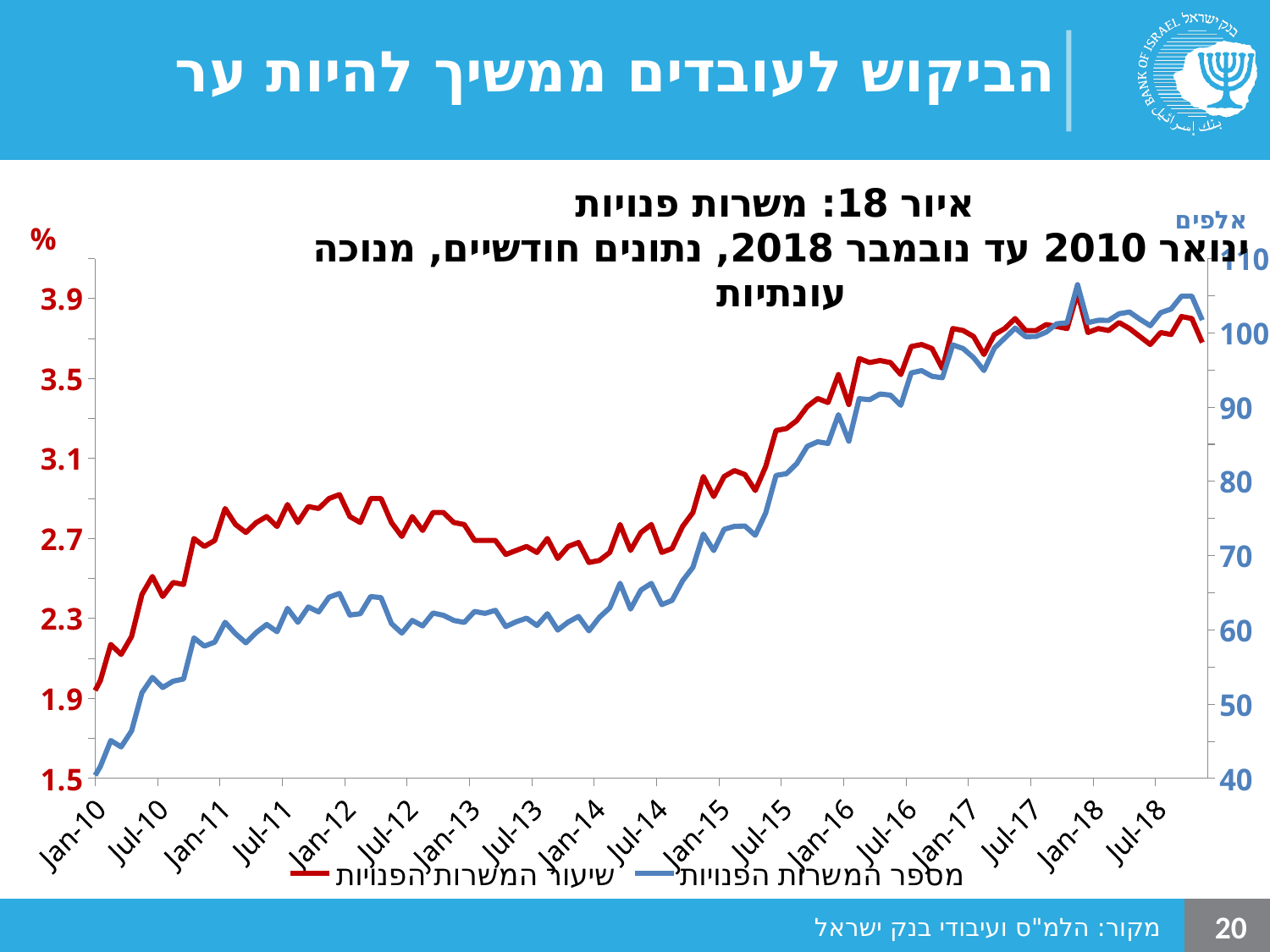
What kind of chart is shown on the slide? line chart What is the title of the chart? איור 18: משרות פנויות ינואר 2010 עד נובמבר 2018, נתונים חודשיים, מנוכה עונתיות Is the value of מספר המשרות הפנויות (blue line) at Jan-18 greater or less than 100? greater How many series does the legend list? 2 Is the value of מספר המשרות הפנויות (blue line) at Jan-12 greater or less than 60? greater Is the value of מספר המשרות הפנויות (blue line) at Jan-10 greater or less than 50? less Overall, does מספר המשרות הפנויות (blue line) rise or fall from Jan-10 to Jul-18? rise Does שיעור המשרות הפנויות (red line) rise or fall from Jan-12 to Jan-14? fall Which series is drawn in red? שיעור המשרות הפנויות